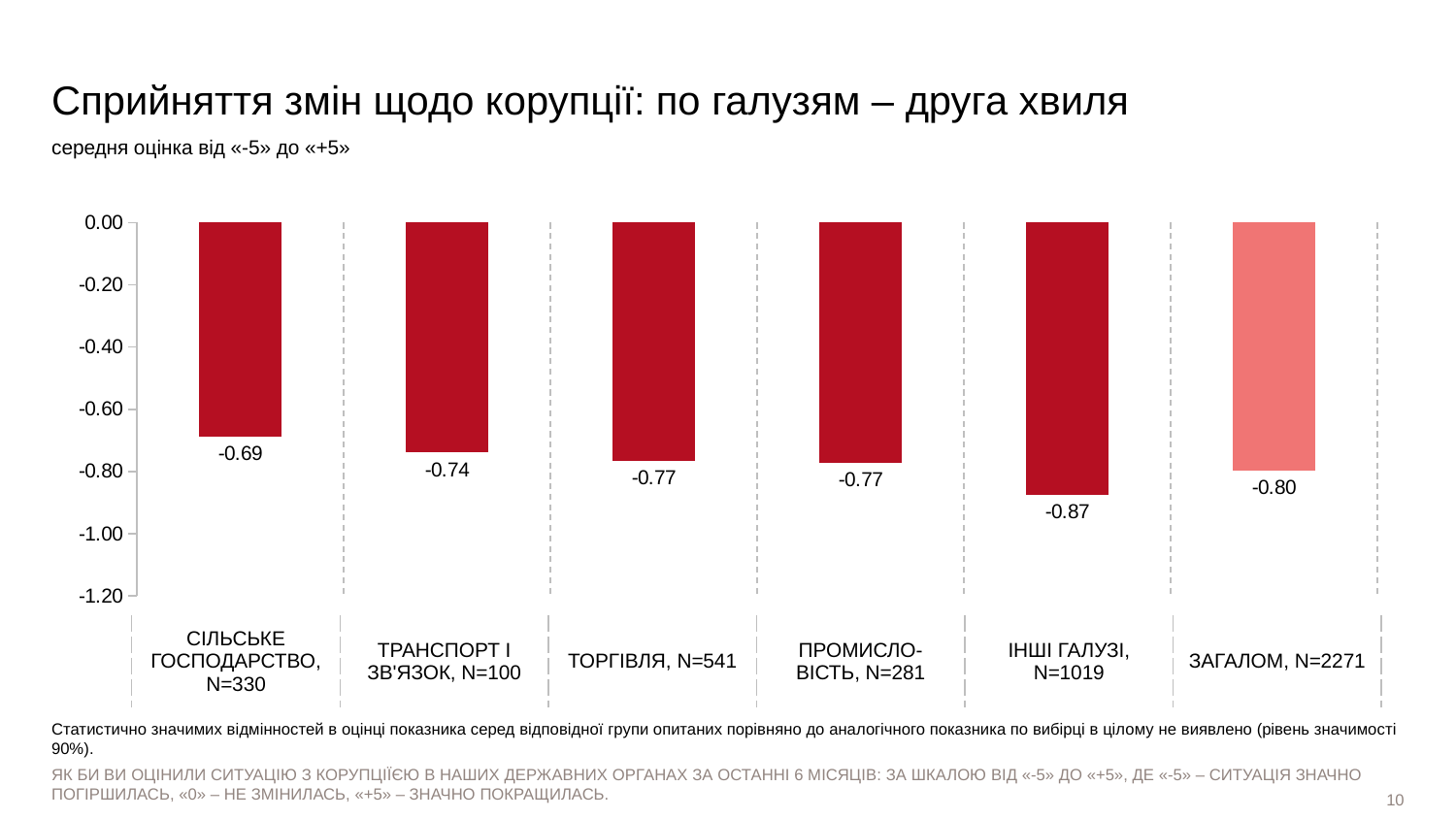
What is the value for ЗАГАЛОМ, N=2271? -0.80 Which bar is shown in a lighter colour than the others? ЗАГАЛОМ, N=2271 Is the value for ПРОМИСЛОВІСТЬ, N=281 greater or less than -0.60? less What is the value for ТРАНСПОРТ І ЗВ'ЯЗОК, N=100? -0.74 What is the value for ТОРГІВЛЯ, N=541? -0.77 What is the title of the chart? Сприйняття змін щодо корупції: по галузям – друга хвиля What kind of chart is shown on the slide? bar chart Which category has the lowest value? ІНШІ ГАЛУЗІ, N=1019 How many categories are shown on the chart? 6 Which is larger, the value for ТРАНСПОРТ І ЗВ'ЯЗОК, N=100 or the value for ЗАГАЛОМ, N=2271? ТРАНСПОРТ І ЗВ'ЯЗОК, N=100 Which category has the highest value? СІЛЬСЬКЕ ГОСПОДАРСТВО, N=330 What is the difference between the values for ІНШІ ГАЛУЗІ, N=1019 and СІЛЬСЬКЕ ГОСПОДАРСТВО, N=330? 0.18